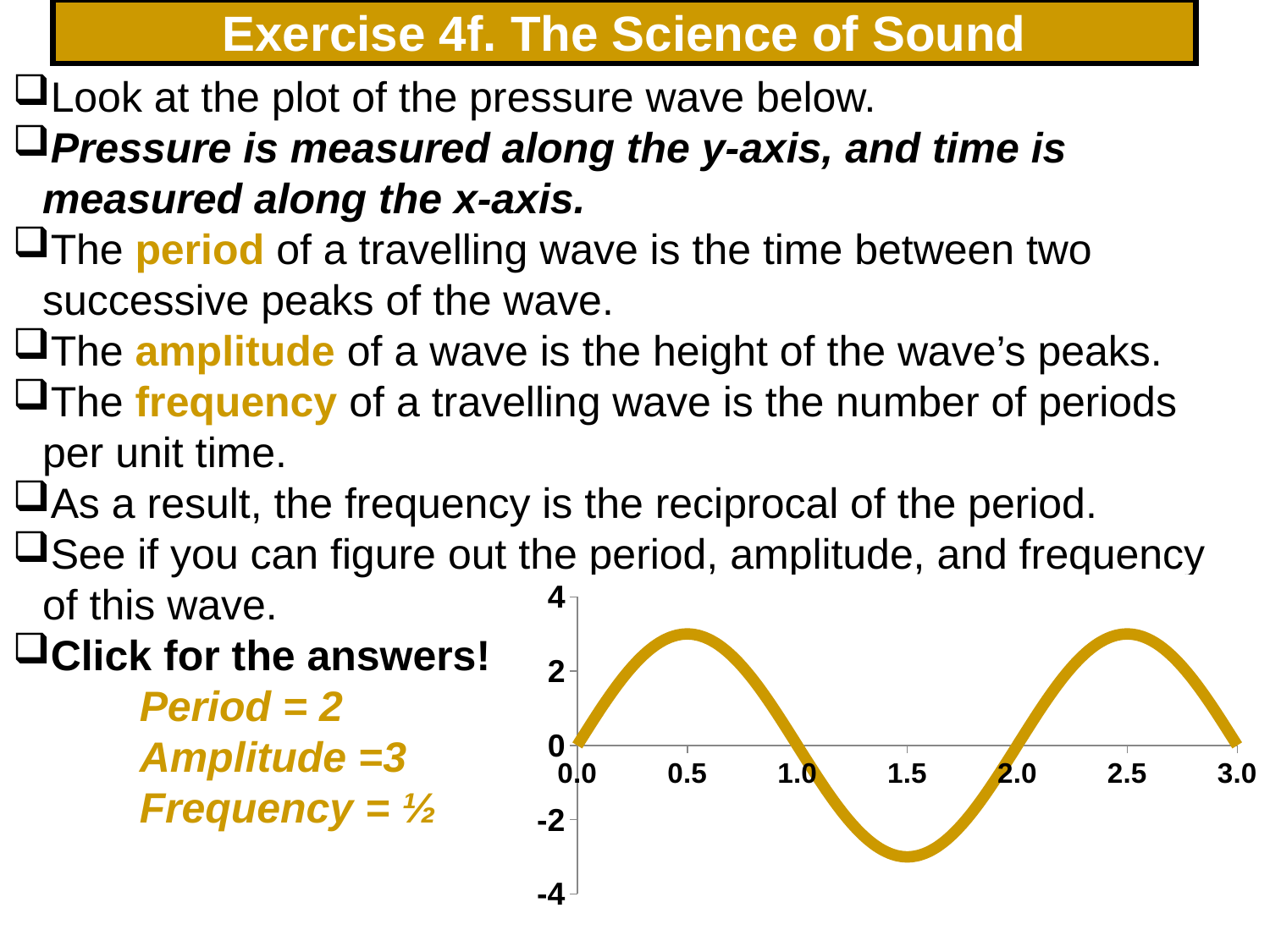
What is the value of the wave at x = 2.0? 0 Is the value of the wave at x = 2.5 greater or less than 2? greater Between x = 0.0 and x = 1.0, at which x value does the wave reach its highest point? 0.5 Is the value of the wave at x = 1.5 greater or less than -2? less How many tick labels are shown on the x-axis? 7 What is the value of the wave at x = 1.0? 0 Which is larger, the value of the wave at x = 0.5 or at x = 1.5? x = 0.5 Between x = 1.0 and x = 2.0, at which x value does the wave reach its lowest point? 1.5 Does the wave rise or fall as x goes from 0.0 to 0.5? rise Is the value of the wave at x = 0.5 greater or less than 2? greater What colour is the wave line in the chart? gold What kind of chart is shown on the slide? line chart